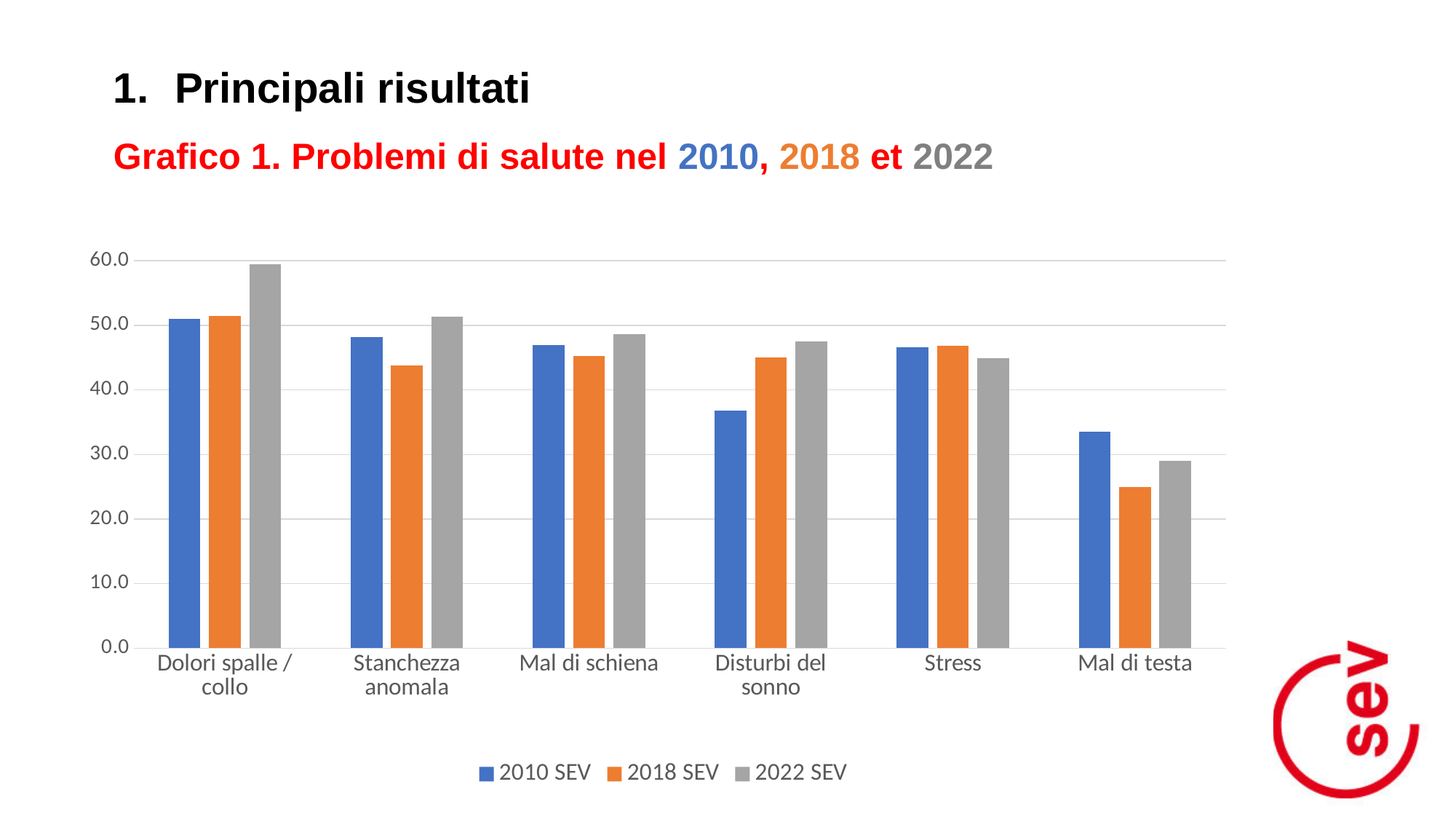
Is the 2022 SEV value for Dolori spalle / collo greater or less than 50? greater Is the 2018 SEV value for Mal di testa greater or less than 30? less Which category has the lowest 2018 SEV bar? Mal di testa What are the three entries listed in the chart legend? 2010 SEV, 2018 SEV, 2022 SEV How many health problem categories are shown on the x axis? 6 What kind of chart is shown on the slide? bar chart Is the 2010 SEV value for Disturbi del sonno greater or less than 40? less For Mal di testa, which is larger: the 2010 SEV value or the 2018 SEV value? 2010 SEV For Disturbi del sonno, which is larger: the 2010 SEV value or the 2022 SEV value? 2022 SEV Which category has the highest 2022 SEV bar? Dolori spalle / collo Which category has the lowest 2010 SEV bar? Mal di testa How many series does the legend list? 3